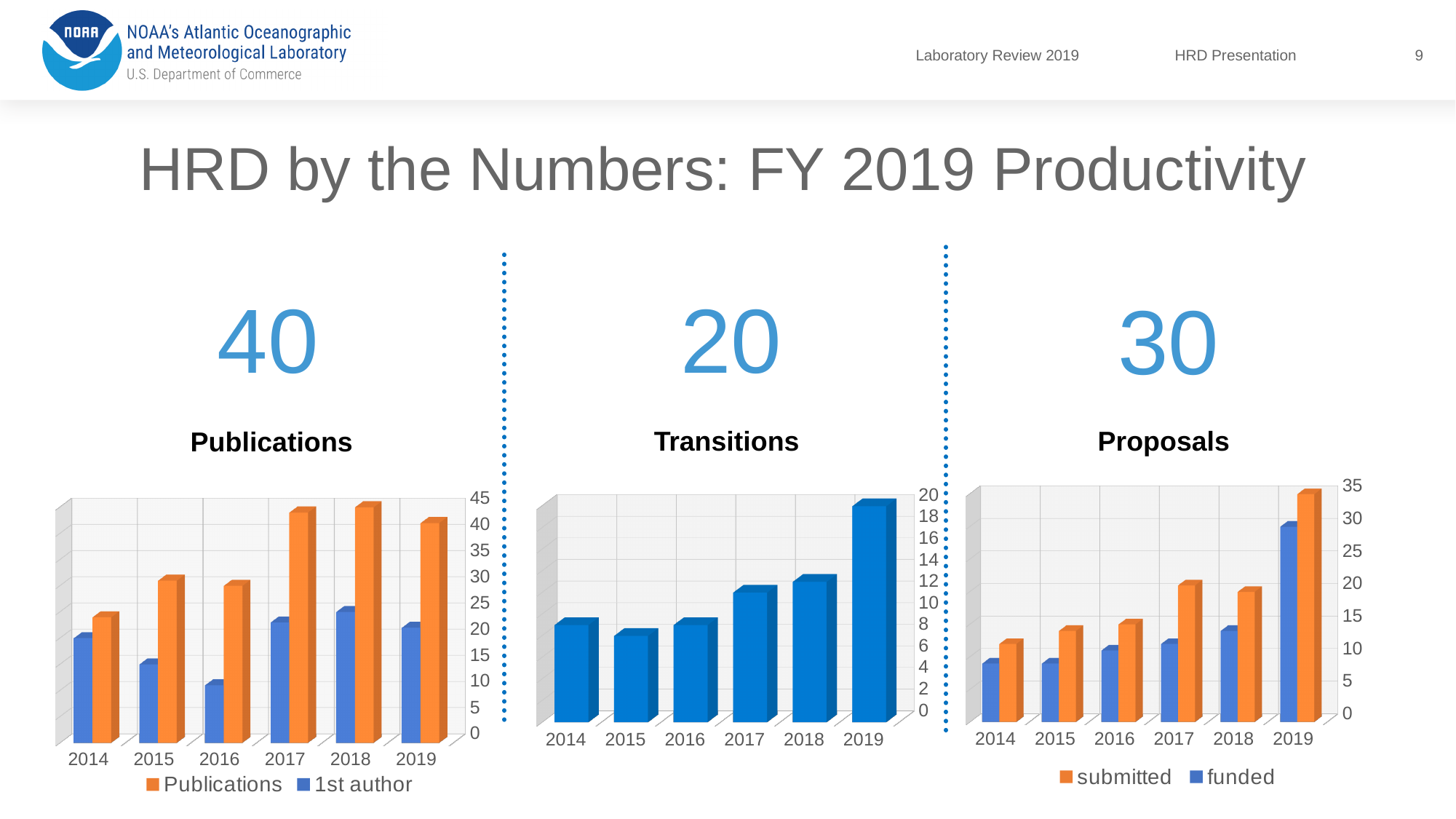
In the Proposals chart, which year has the highest submitted value? 2019 In the Transitions chart, is the value for 2014 greater or less than 10? less In the Proposals chart, what are the two series named in the legend? submitted and funded In the Publications chart, how many series does the legend list? 2 In the Transitions chart, which year has the highest value? 2019 In the Publications chart, which year has the lowest 1st author value? 2016 In the Publications chart, is the Publications value for 2018 greater or less than 40? greater In the Publications chart, which year has the lowest Publications value? 2014 How many years are shown on the x axis of the Transitions chart? 6 In the Proposals chart, is the funded value for 2019 greater or less than 25? greater What kind of chart is the Transitions chart? bar chart